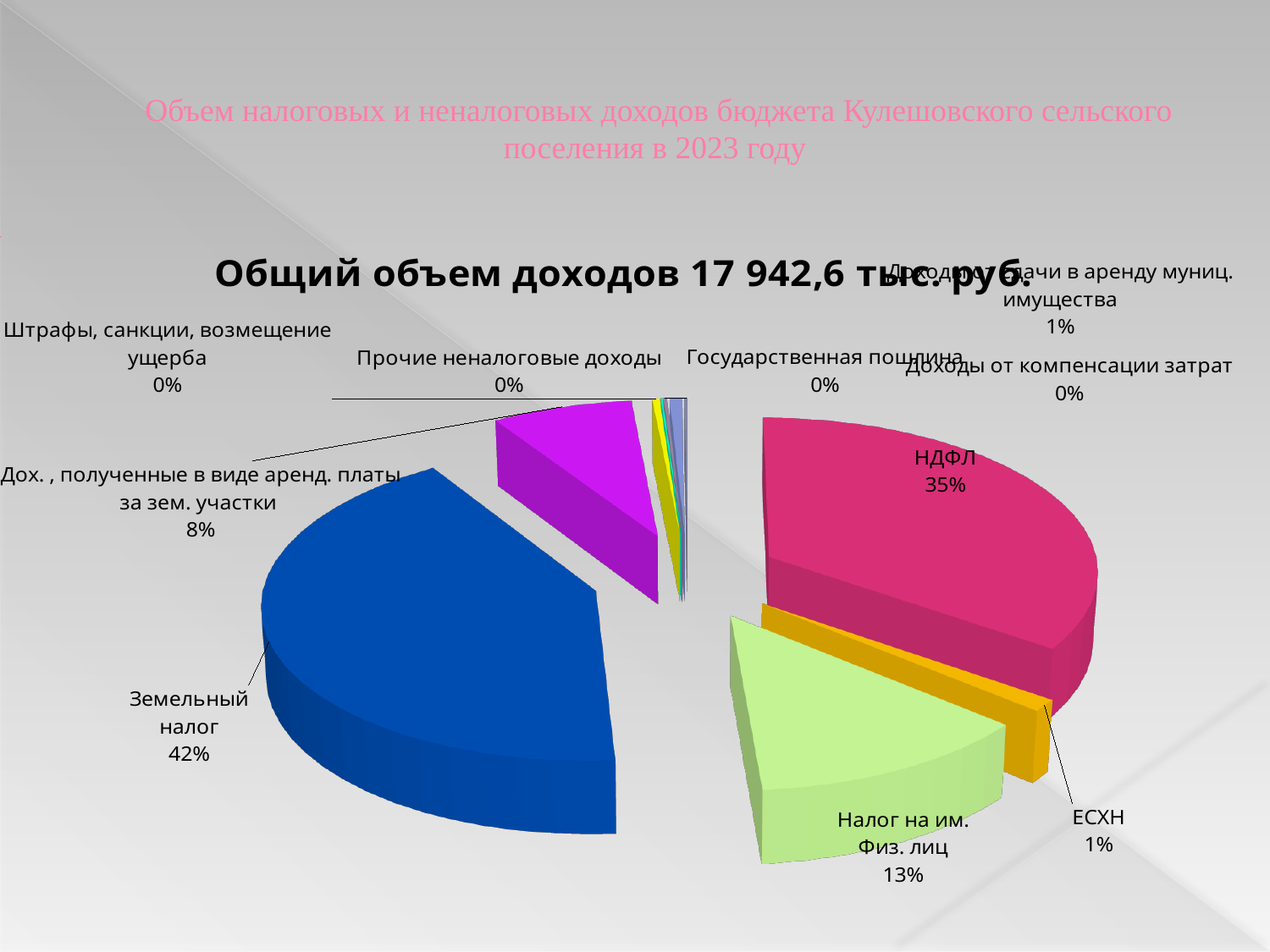
What share of the pie does НДФЛ have? 35% What share of the pie does Земельный налог have? 42% Which is larger, the share for НДФЛ or the share for Налог на им. Физ. лиц? НДФЛ What share of the pie does Налог на им. Физ. лиц have? 13% What is the difference in percentage points between the shares of Земельный налог and НДФЛ? 7% What is the total income amount stated in the chart title? 17 942,6 тыс. руб. Which category has the largest share of the pie? Земельный налог What kind of chart is shown on the slide? Pie chart What colour is the slice for Земельный налог? Blue How many categories are labelled on the pie chart? 10